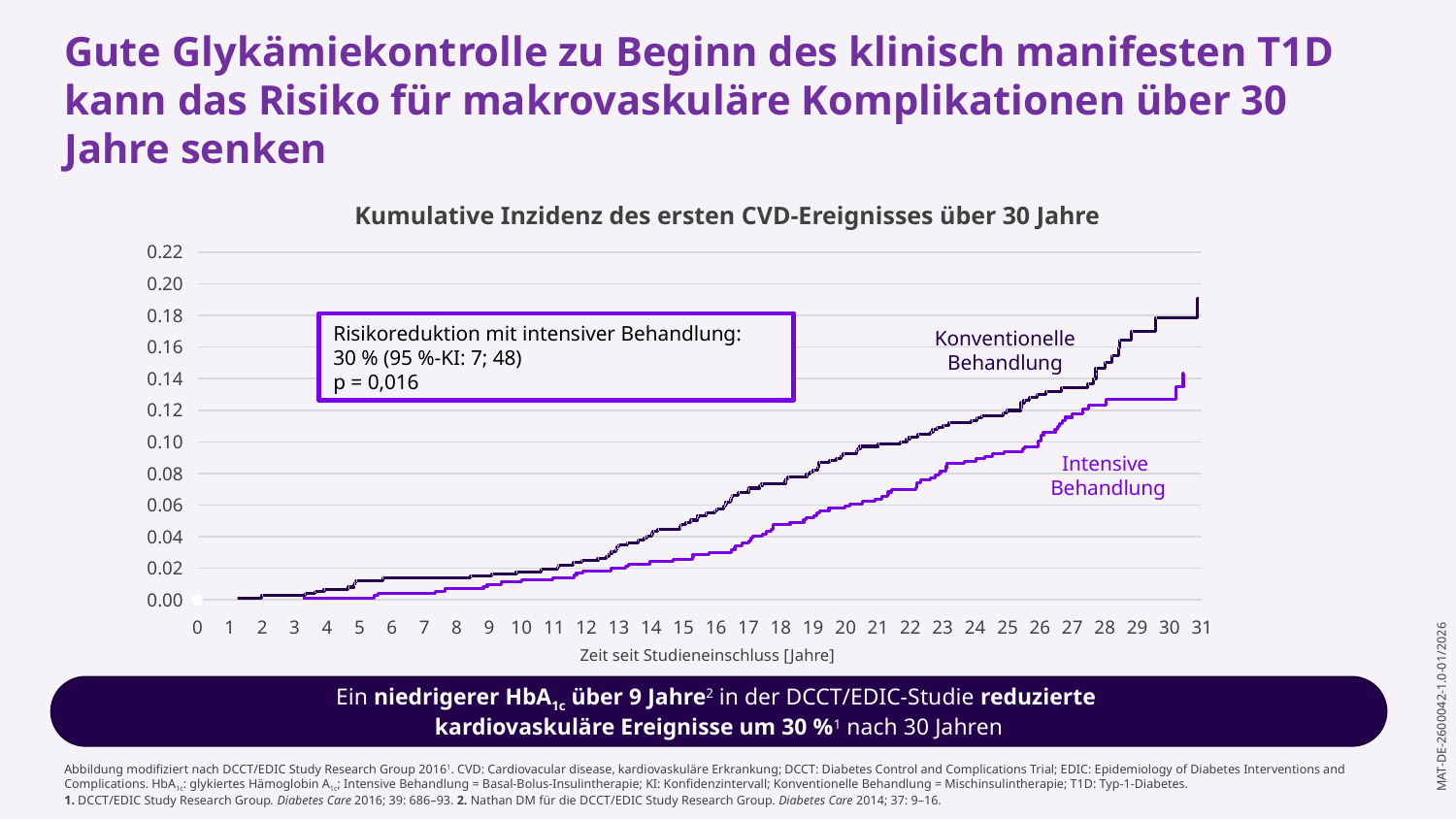
What is the label of the x axis? Zeit seit Studieneinschluss [Jahre] What is the title of the chart? Kumulative Inzidenz des ersten CVD-Ereignisses über 30 Jahre Is the value for Intensive Behandlung at year 30 greater or less than 0.16? less Do the cumulative incidence curves rise or fall as time since study enrolment increases? rise What is the last year shown on the x axis? 31 Is the value for Intensive Behandlung at year 20 greater or less than 0.08? less How many series (treatment groups) are plotted in the chart? 2 What is the highest value shown on the y axis? 0.22 What kind of chart is shown on the slide? line chart Is the value for Konventionelle Behandlung at year 30 greater or less than 0.16? greater At year 30, which curve is higher: Konventionelle Behandlung or Intensive Behandlung? Konventionelle Behandlung